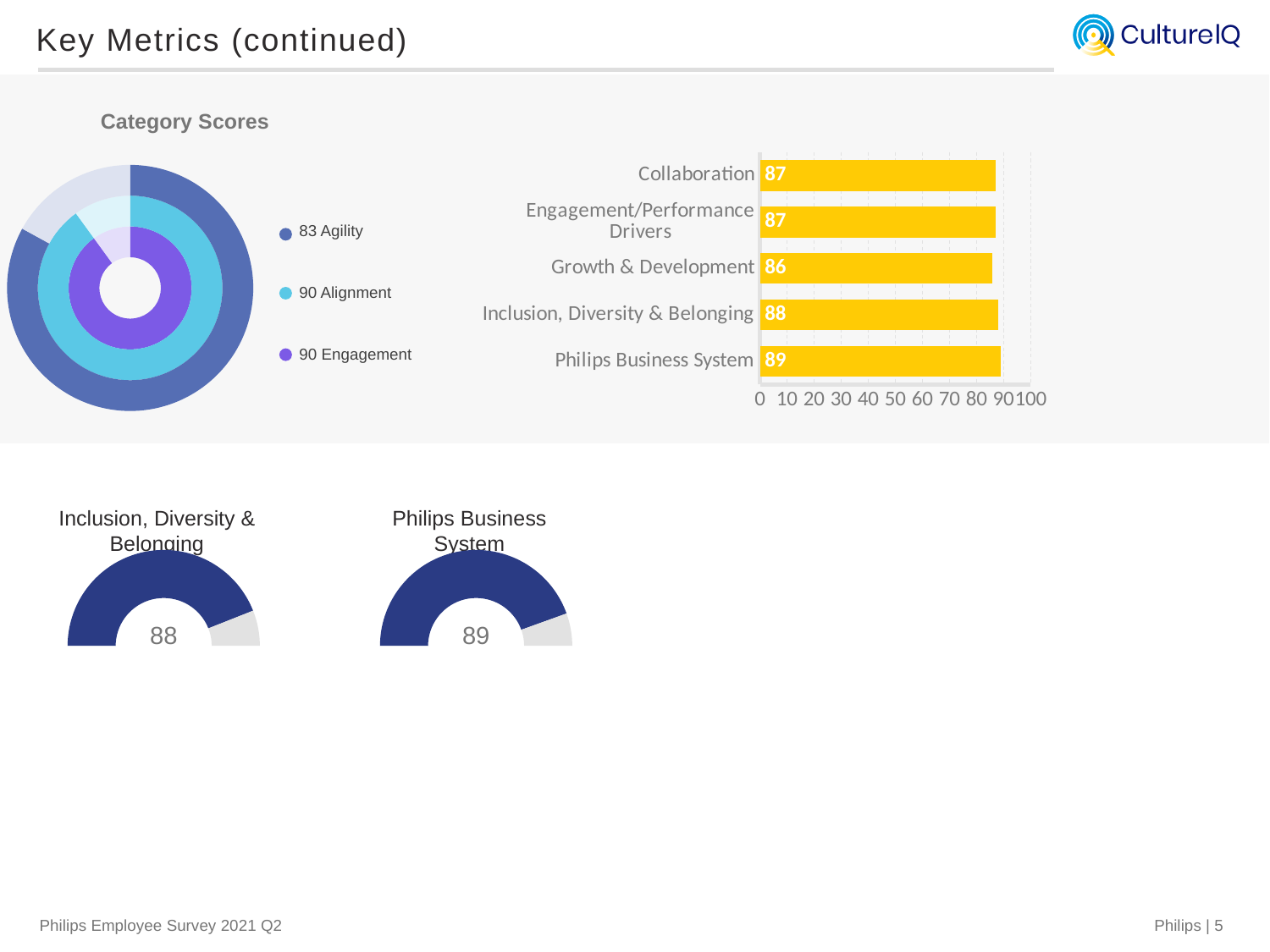
In the horizontal bar chart at the top right, what is the value for Philips Business System? 89 What kind of chart is the yellow chart at the top right of the slide? bar chart In the horizontal bar chart at the top right, what is the value for Collaboration? 87 In the Category Scores donut chart at the top left, how many entries does the legend list? 3 In the Category Scores donut chart at the top left, which category has the lowest value? Agility In the horizontal bar chart at the top right, what is the difference between the values for Philips Business System and Growth & Development? 3 In the horizontal bar chart at the top right, which category has the highest value? Philips Business System In the horizontal bar chart at the top right, how many categories are shown? 5 In the gauge chart titled Inclusion, Diversity & Belonging at the bottom left, what value is shown? 88 In the horizontal bar chart at the top right, which category has the lowest value? Growth & Development In the Category Scores donut chart at the top left, what is the value for Agility? 83 In the horizontal bar chart at the top right, what is the value for Growth & Development? 86